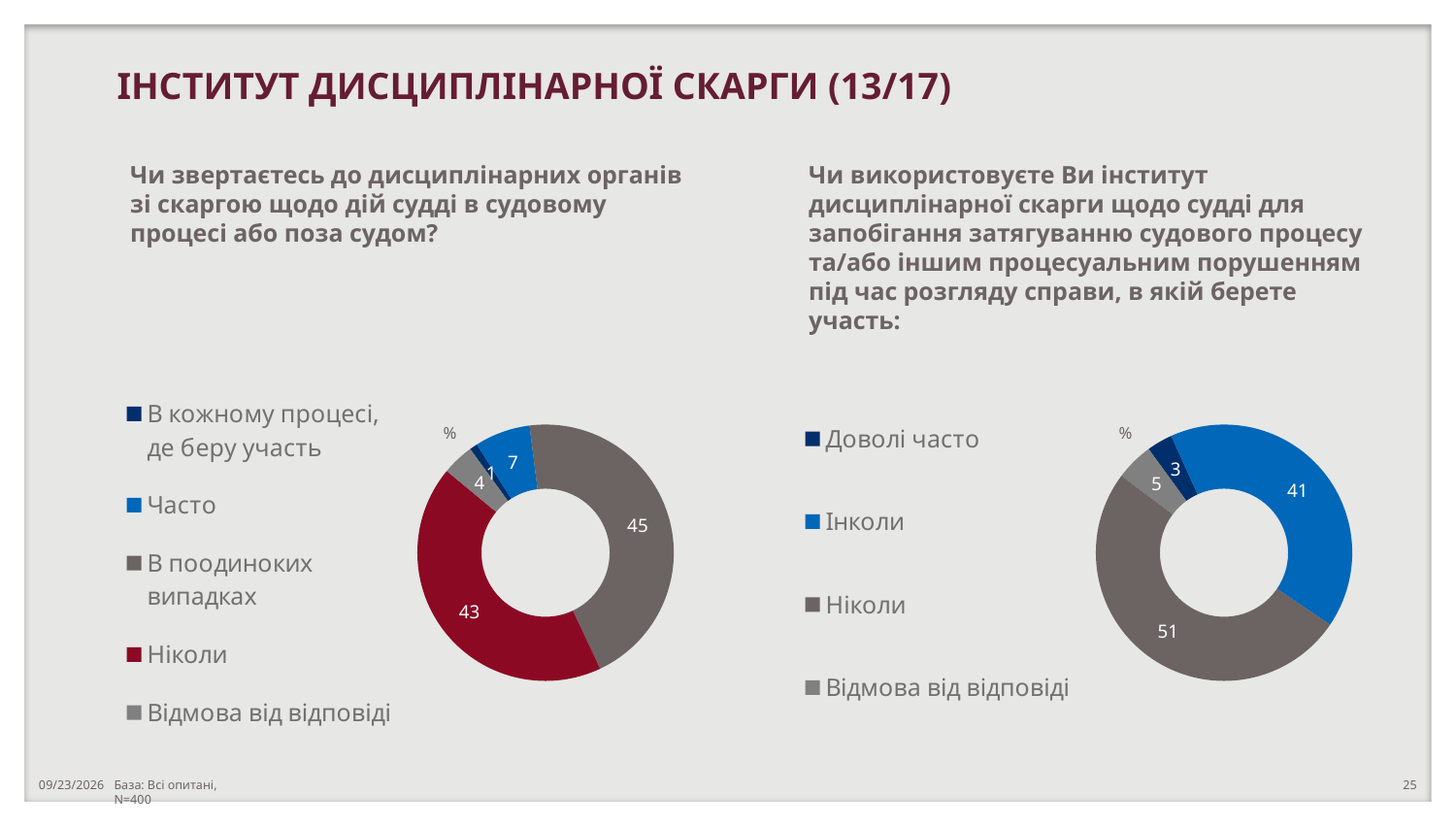
In the right chart, what is the value for 'Інколи'? 41 In the right chart, what is the difference between 'Ніколи' and 'Інколи'? 10 In the left chart (Чи звертаєтесь до дисциплінарних органів зі скаргою...), what is the value for 'В поодиноких випадках'? 45 In the left chart, which category has the highest value? В поодиноких випадках What type of chart is used on the right side of the slide? Pie (donut) chart In the left chart, what is the value for 'Ніколи'? 43 In the left chart, which category has the lowest value? В кожному процесі, де беру участь In the left chart, what is the difference between 'Ніколи' and 'Часто'? 36 In the left chart, what is the value for 'Часто'? 7 How many categories does the legend of the left chart list? 5 In the right chart (Чи використовуєте Ви інститут дисциплінарної скарги...), what is the value for 'Ніколи'? 51 In the right chart, which is larger: 'Доволі часто' or 'Відмова від відповіді'? Відмова від відповіді